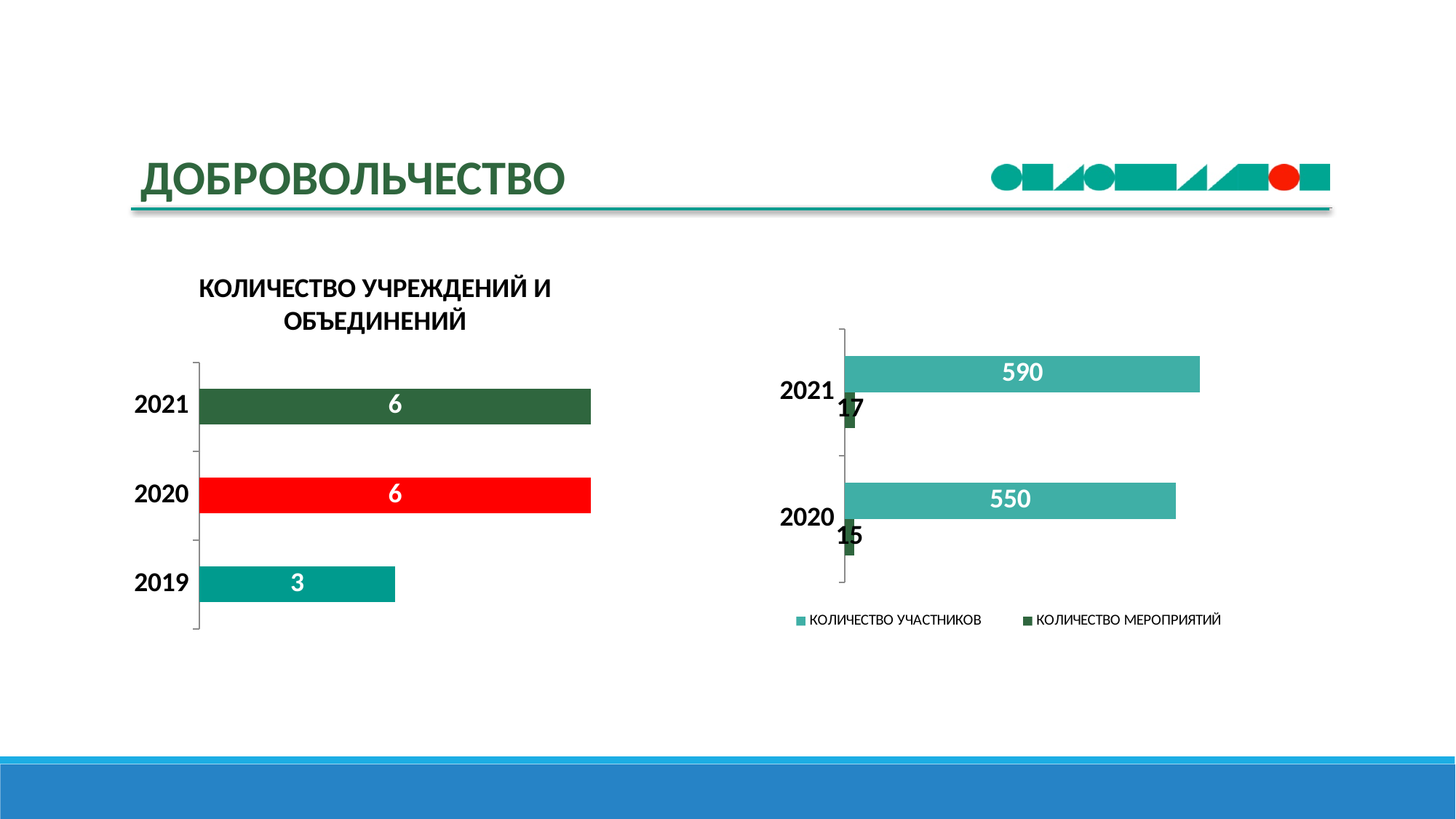
In the chart titled 'КОЛИЧЕСТВО УЧРЕЖДЕНИЙ И ОБЪЕДИНЕНИЙ', how many years are shown? 3 In the chart titled 'КОЛИЧЕСТВО УЧРЕЖДЕНИЙ И ОБЪЕДИНЕНИЙ', which year has the lowest value? 2019 In the chart on the right, which year has the higher value of 'КОЛИЧЕСТВО МЕРОПРИЯТИЙ', 2020 or 2021? 2021 In the chart on the right, what is the difference between 'КОЛИЧЕСТВО УЧАСТНИКОВ' in 2021 and 2020? 40 In the chart titled 'КОЛИЧЕСТВО УЧРЕЖДЕНИЙ И ОБЪЕДИНЕНИЙ', what is the value for 2019? 3 In the chart titled 'КОЛИЧЕСТВО УЧРЕЖДЕНИЙ И ОБЪЕДИНЕНИЙ', what is the difference between the values for 2020 and 2019? 3 In the chart on the right, what is the value of 'КОЛИЧЕСТВО МЕРОПРИЯТИЙ' for 2020? 15 In the chart on the right, how many series does the legend list? 2 In the chart on the right, what colour are the 'КОЛИЧЕСТВО МЕРОПРИЯТИЙ' bars? dark green What kind of chart is the chart titled 'КОЛИЧЕСТВО УЧРЕЖДЕНИЙ И ОБЪЕДИНЕНИЙ'? bar chart In the chart titled 'КОЛИЧЕСТВО УЧРЕЖДЕНИЙ И ОБЪЕДИНЕНИЙ', what is the value for 2021? 6 In the chart on the right, what is the value of 'КОЛИЧЕСТВО УЧАСТНИКОВ' for 2021? 590